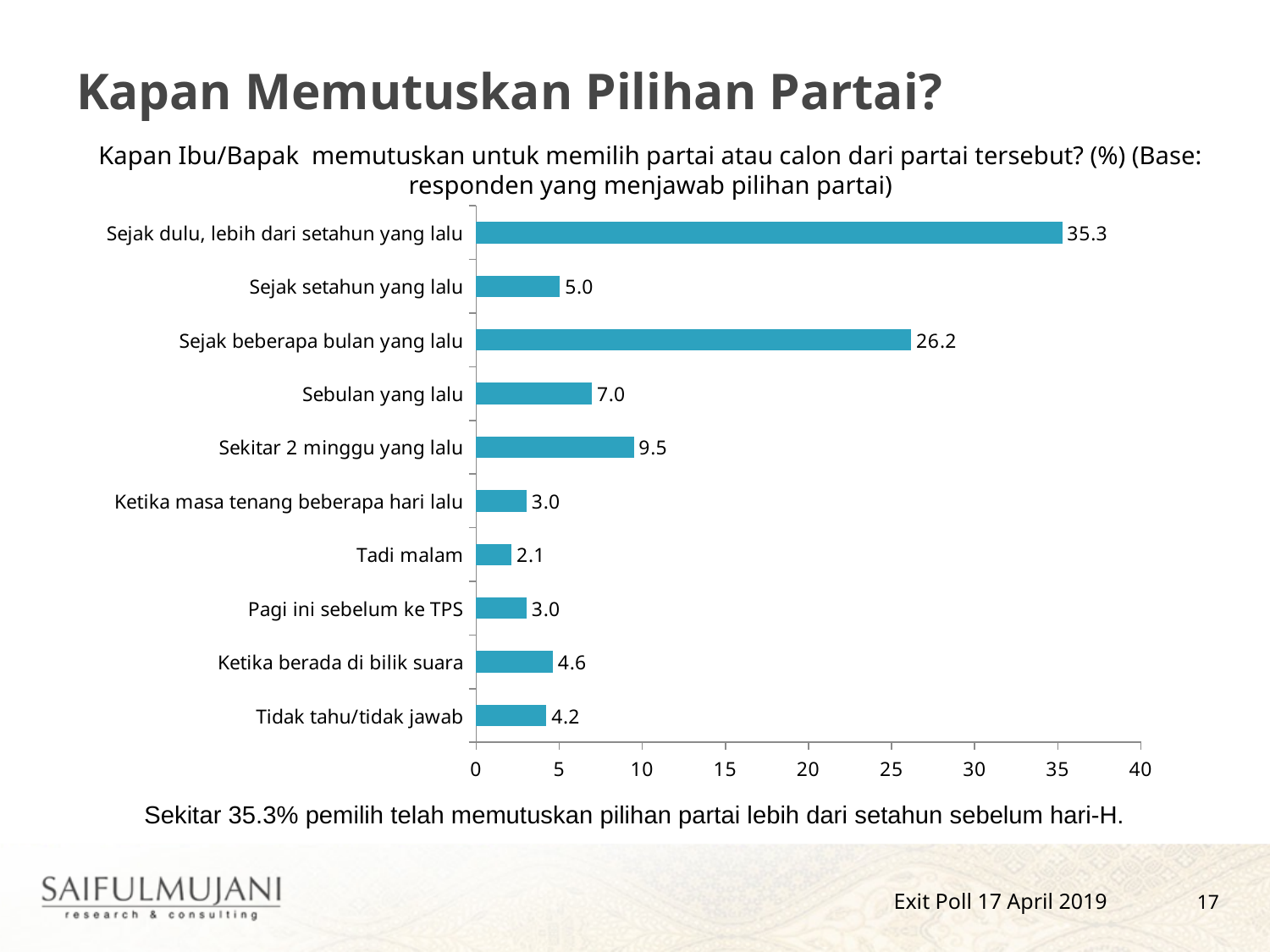
Which category has the highest value? Sejak dulu, lebih dari setahun yang lalu What is the maximum value shown on the horizontal axis? 40 What is the value for "Sekitar 2 minggu yang lalu"? 9.5 How many categories are shown in the chart? 10 Which is larger, the value for "Sebulan yang lalu" or the value for "Sejak setahun yang lalu"? Sebulan yang lalu What is the value for "Sejak beberapa bulan yang lalu"? 26.2 What is the difference between the values for "Sejak dulu, lebih dari setahun yang lalu" and "Sejak beberapa bulan yang lalu"? 9.1 What is the value for "Ketika berada di bilik suara"? 4.6 What is the value for "Sejak dulu, lebih dari setahun yang lalu"? 35.3 Is the value for "Sejak beberapa bulan yang lalu" greater or less than 25? greater What kind of chart is shown on the slide? bar chart Which category has the lowest value? Tadi malam